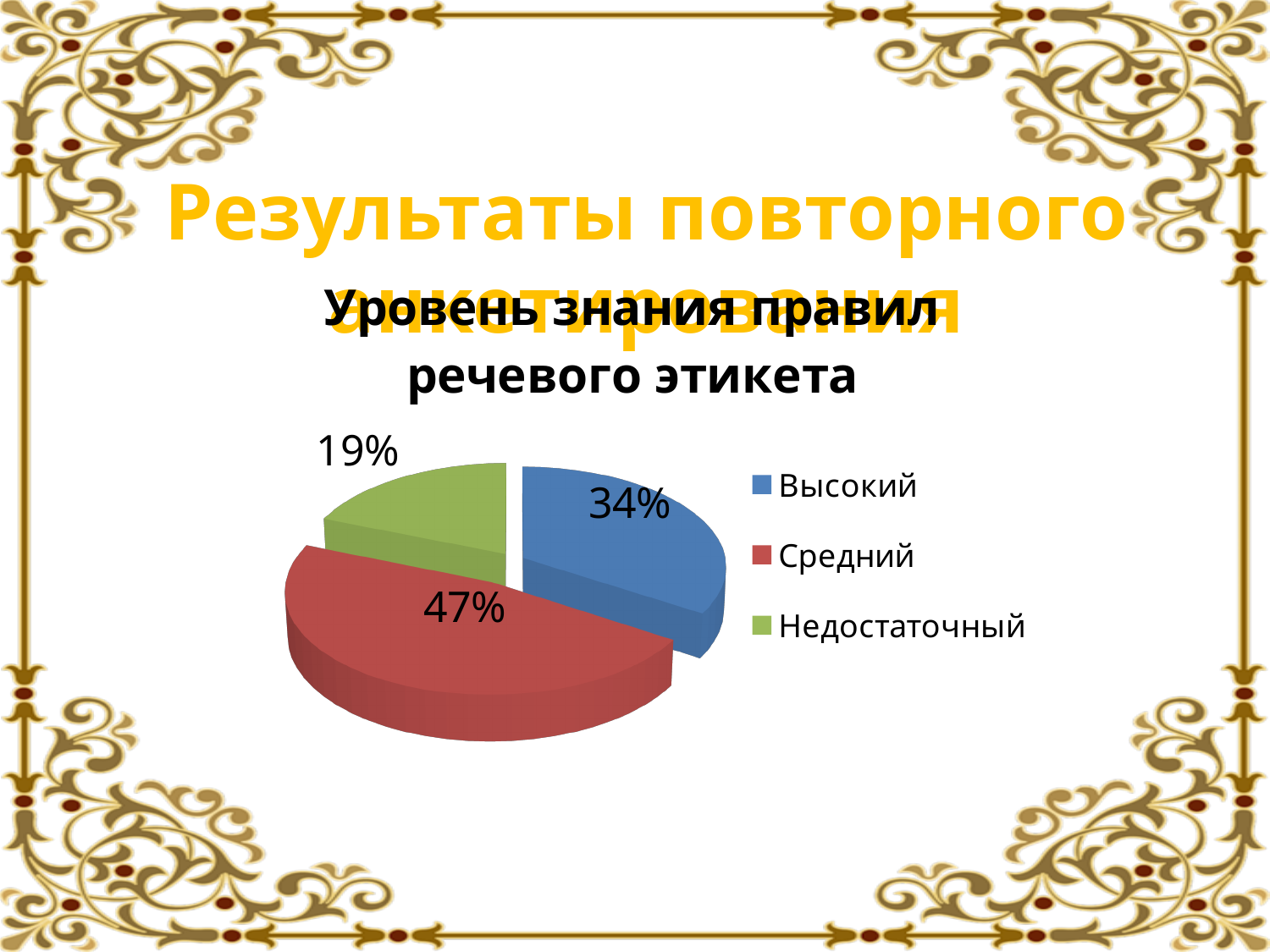
What share of the pie does the "Средний" slice represent? 47% Which category has the smallest slice of the pie? Недостаточный How many entries does the legend list? 3 How many categories does the pie chart show? 3 What is the difference in percentage points between the "Средний" and "Высокий" slices? 13 What colour is the "Недостаточный" slice in the pie chart? Green What share of the pie does the "Высокий" slice represent? 34% What is the title of the chart? Уровень знания правил речевого этикета What type of chart is shown on the slide? Pie chart Which is larger, the "Высокий" slice or the "Недостаточный" slice? Высокий What share of the pie does the "Недостаточный" slice represent? 19% Which category has the largest slice of the pie? Средний